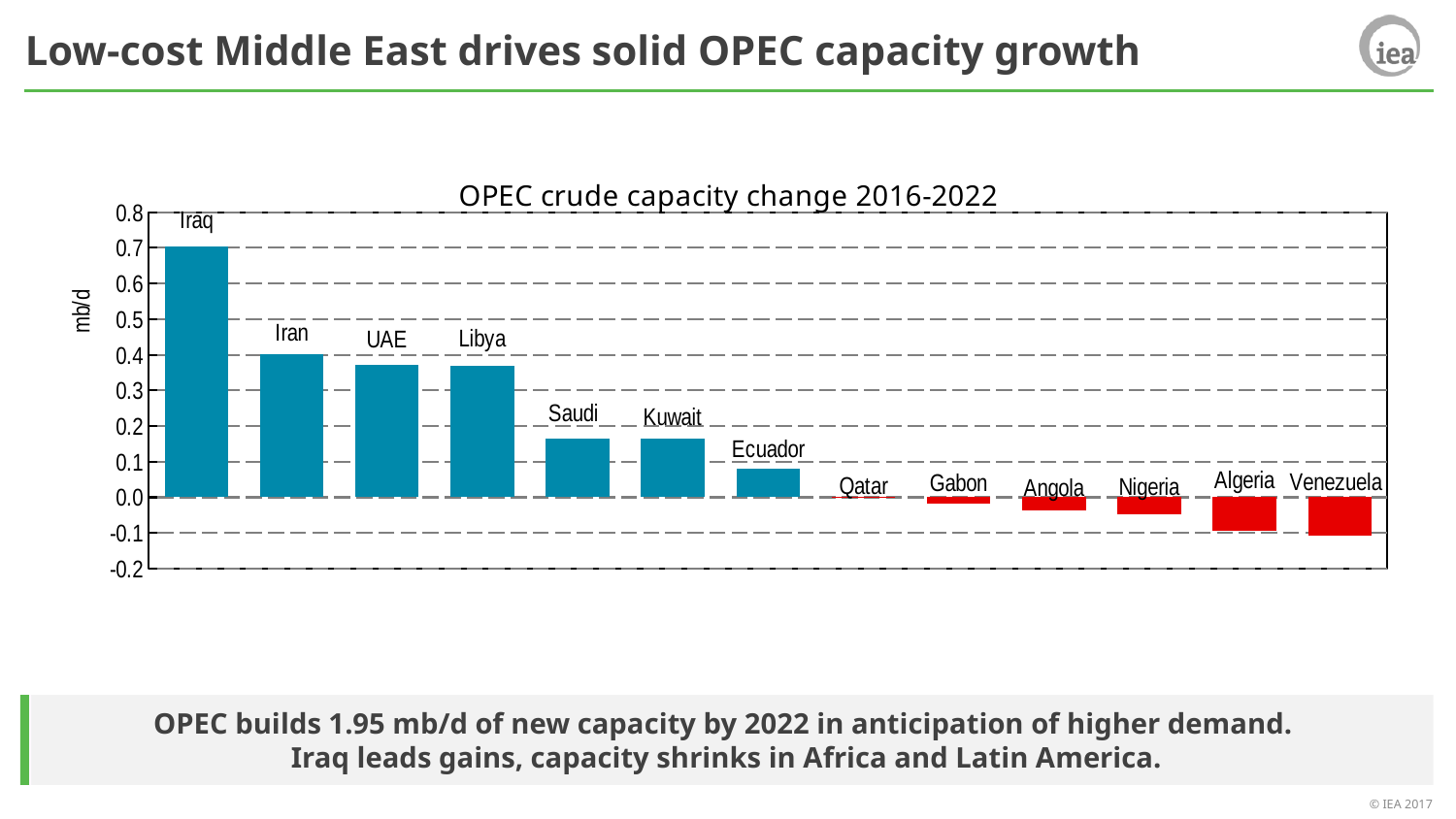
Which is larger, the value for Libya or the value for Saudi? Libya Is the value for Iran greater or less than 0.3? greater How many countries are shown in the chart? 13 What unit is shown on the y axis of the chart? mb/d Is the value for Saudi greater or less than 0.2? less Which country has the highest crude capacity change? Iraq Which is larger, the value for Iraq or the value for Iran? Iraq Do the values generally rise or fall moving from left to right along the x axis? fall Is the value for Ecuador greater or less than 0.1? less What is the title of the chart? OPEC crude capacity change 2016-2022 What type of chart is shown on the slide? bar chart What is the crude capacity change for Iraq, in mb/d? 0.7